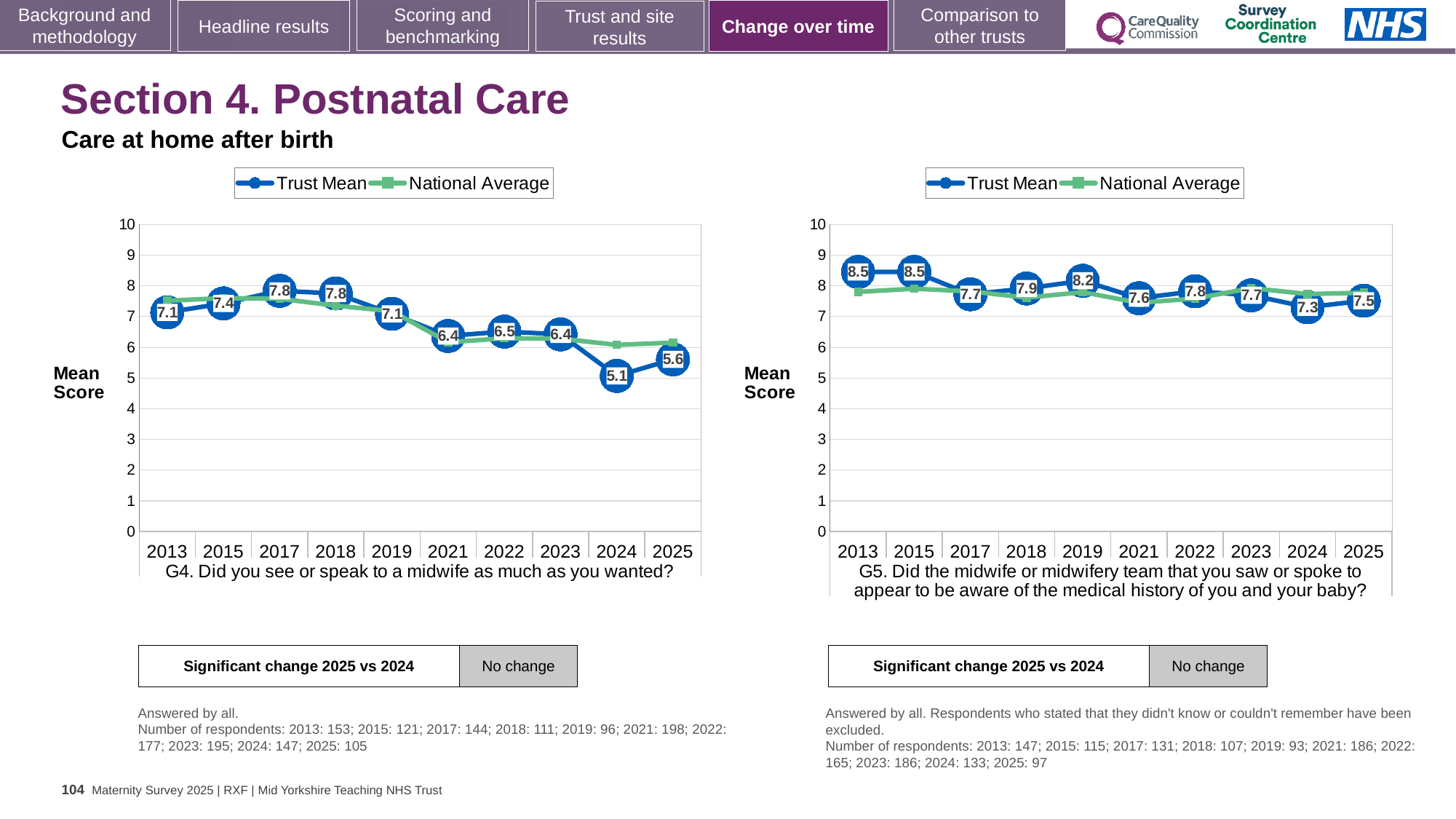
In the G5 chart, what is the difference between the Trust Mean scores for 2013 and 2025? 1.0 In the G4 chart, what is the Trust Mean score for 2024? 5.1 In the G4 chart, what is the difference between the Trust Mean scores for 2025 and 2024? 0.5 How many years are plotted on the x axis of the G4 chart? 10 In the G5 chart, is the National Average value for 2013 greater or less than 7? greater In the G4 chart, what is the Trust Mean score for 2013? 7.1 In the G5 chart, what is the Trust Mean score for 2019? 8.2 In the G5 chart, what is the Trust Mean score for 2025? 7.5 In the G4 chart, is the Trust Mean score higher in 2017 or in 2021? 2017 What kind of chart is the G5 chart? line chart In the G4 chart, which year has the lowest Trust Mean score? 2024 In the G5 chart, which year has the lowest Trust Mean score? 2024